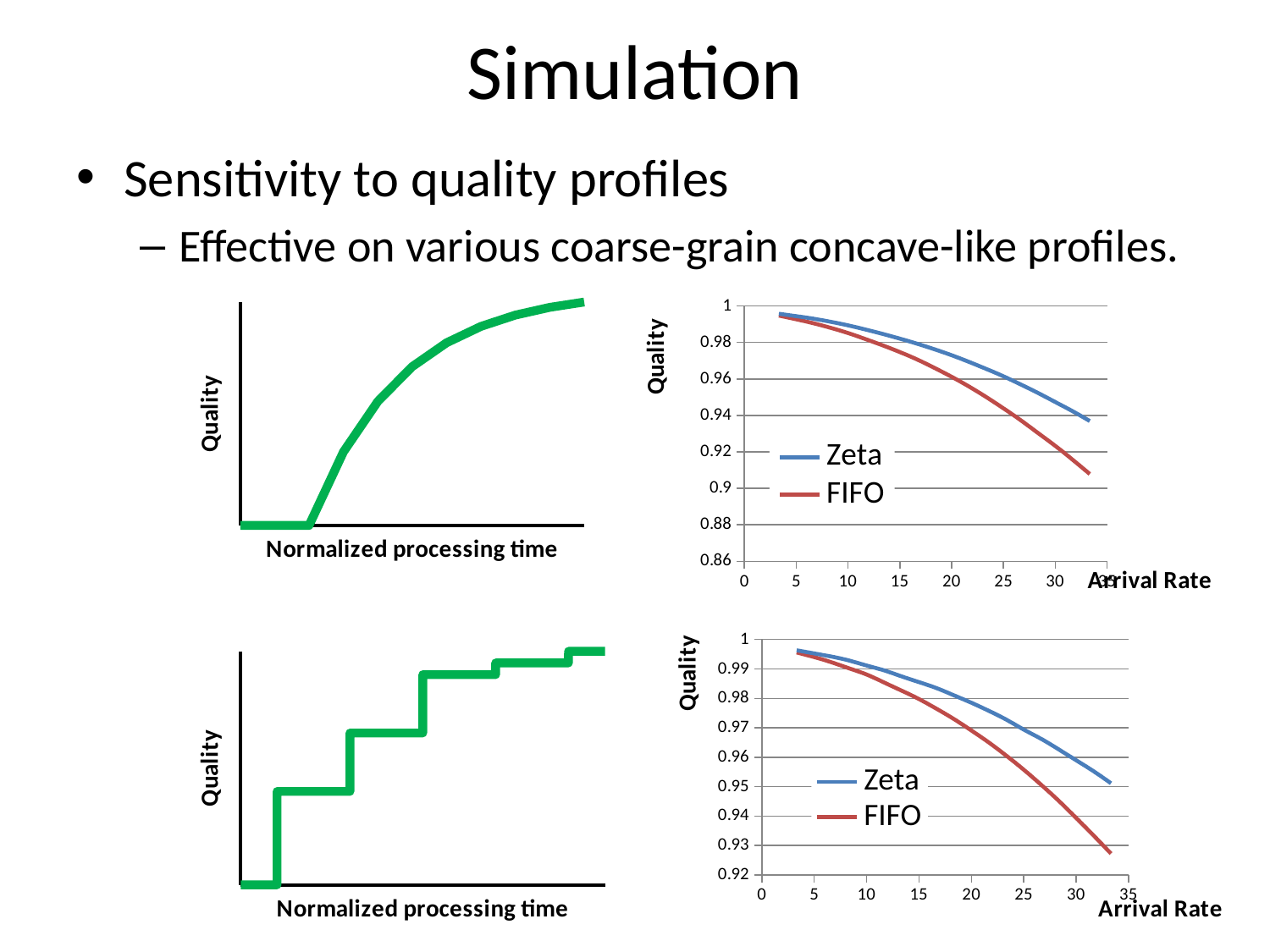
In the bottom-right chart, is the FIFO value at an Arrival Rate of 30 greater or less than 0.95? less How many series does the legend of the top-right chart list? 2 In the top-right chart, is the Zeta value at an Arrival Rate of 10 greater or less than 0.98? greater What is the x-axis label of the bottom-left green chart? Normalized processing time In the bottom-right chart, does the FIFO line rise or fall as Arrival Rate increases? fall In the bottom-right chart, is the Zeta value at an Arrival Rate of 10 greater or less than 0.98? greater In the top-right chart, which series has the higher Quality at an Arrival Rate of 30, Zeta or FIFO? Zeta What are the two series named in the legend of the bottom-right chart? Zeta and FIFO In the bottom-right chart, which series is lower at an Arrival Rate of 25, Zeta or FIFO? FIFO In the top-right chart, does the Zeta line rise or fall as Arrival Rate increases? fall What kind of chart is the top-right chart with the Arrival Rate axis? line chart